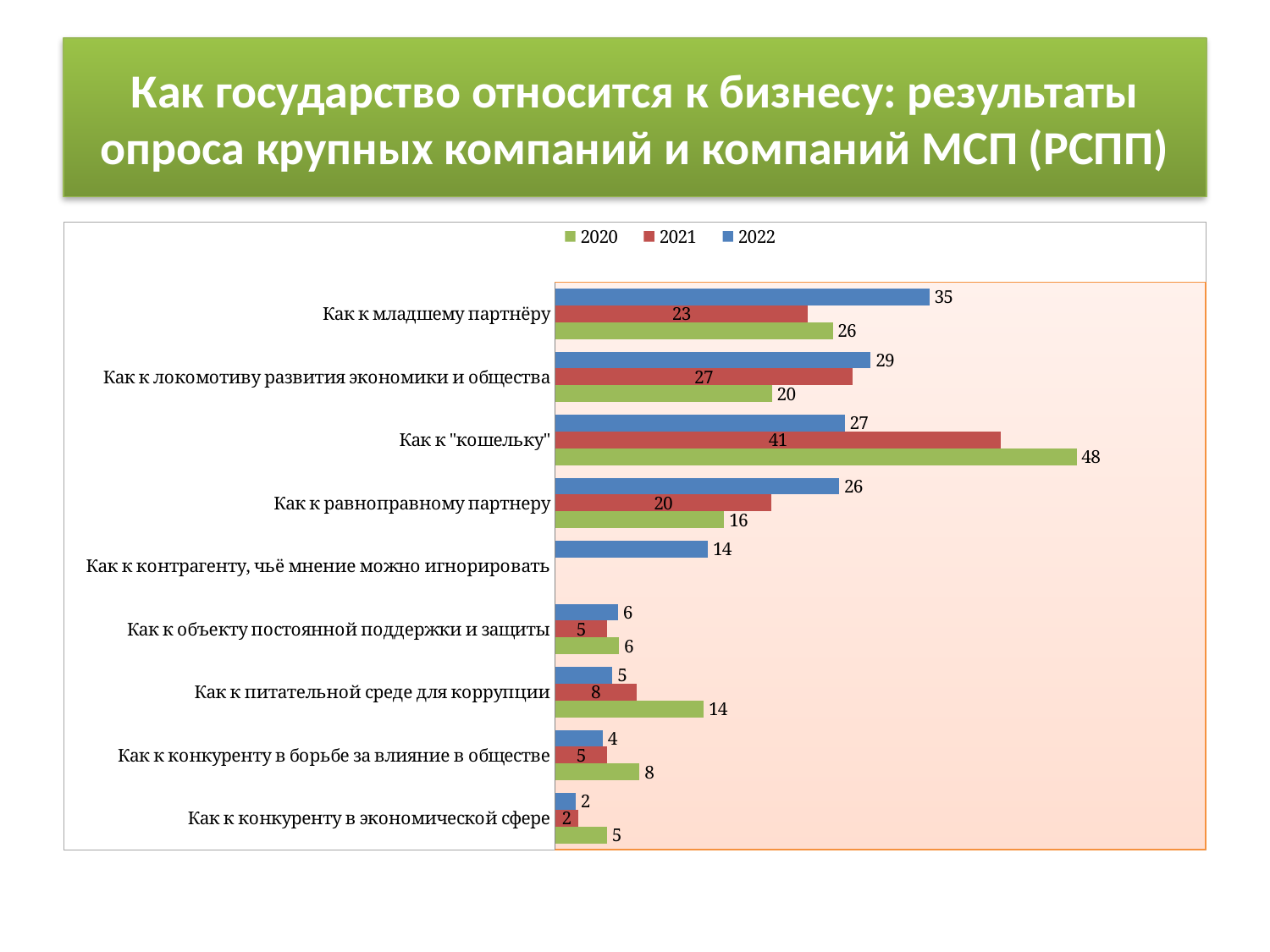
What is the difference between the 2020 and 2022 values for "Как к "кошельку""? 21 What kind of chart is shown on the slide? Bar chart What is the 2022 value for "Как к контрагенту, чьё мнение можно игнорировать"? 14 How many series does the legend list? 3 How many categories are shown on the chart? 9 Which is larger for "Как к равноправному партнеру": the 2021 value or the 2022 value? 2022 Which category has the lowest 2020 value? Как к конкуренту в экономической сфере Which series is shown in green in the legend? 2020 What is the 2021 value for "Как к питательной среде для коррупции"? 8 What is the 2020 value for "Как к "кошельку""? 48 What is the 2022 value for "Как к младшему партнёру"? 35 Which category has the highest 2022 value? Как к младшему партнёру